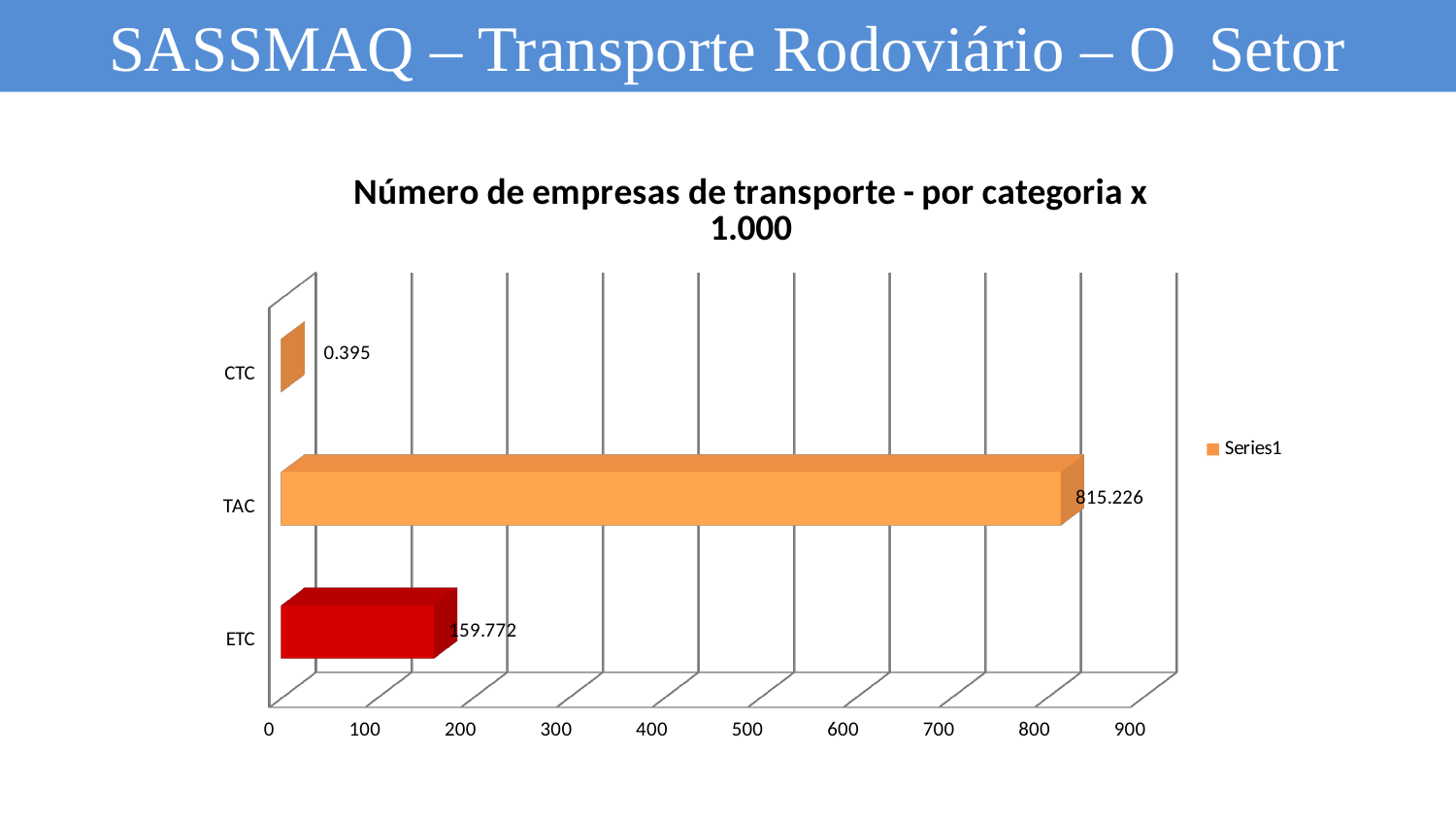
Which category has the highest value? TAC Which is larger, the value for ETC or the value for CTC? ETC What is the difference between the values for ETC and CTC? 159.377 What is the value for ETC? 159.772 How many categories are shown in the chart? 3 What is the difference between the values for TAC and ETC? 655.454 Is the value for TAC greater or less than 800? greater What is the title of the chart? Número de empresas de transporte - por categoria x 1.000 What is the value for CTC? 0.395 What is the value for TAC? 815.226 Which category has the lowest value? CTC What kind of chart is shown on the slide? bar chart